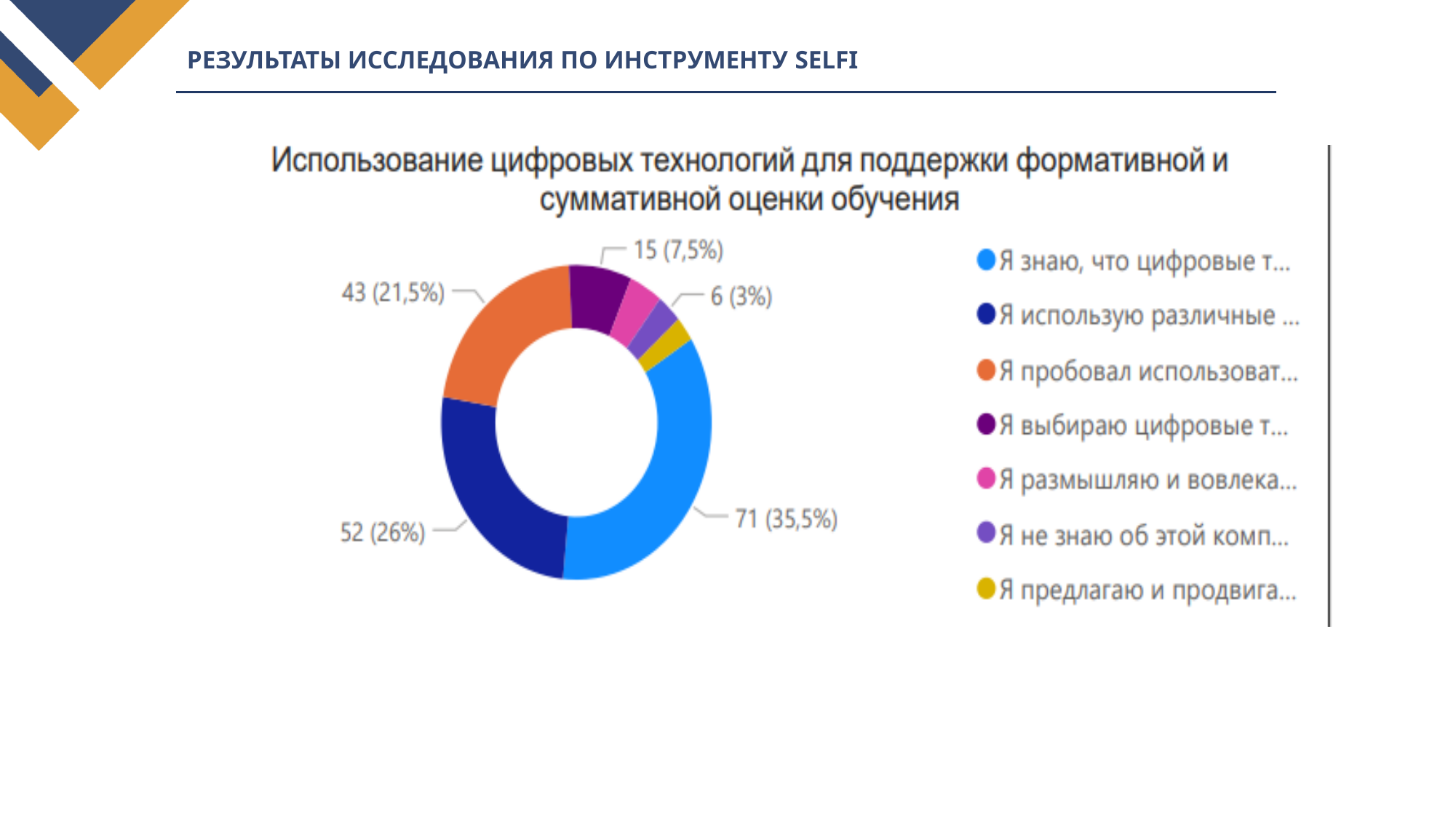
What share of the pie does the "Я знаю, что цифровые т..." slice represent? 35,5% What is the value shown for the orange slice ("Я пробовал использоват...")? 43 (21,5%) What kind of chart is shown on the slide? Pie (donut) chart Which category has the largest slice in the chart? Я знаю, что цифровые т... What is the difference in count between the "Я знаю, что цифровые т..." slice and the "Я использую различные ..." slice? 19 What is the value shown for the light blue slice ("Я знаю, что цифровые т...")? 71 (35,5%) Which is larger: the "Я пробовал использоват..." slice or the "Я выбираю цифровые т..." slice? Я пробовал использоват... What is the value shown for the dark blue slice ("Я использую различные ...")? 52 (26%) What share of the pie does the "Я использую различные ..." slice represent? 26% How many categories does the legend of the chart list? 7 What is the title of the chart? Использование цифровых технологий для поддержки формативной и суммативной оценки обучения What is the value shown for the dark purple slice ("Я выбираю цифровые т...")? 15 (7,5%)